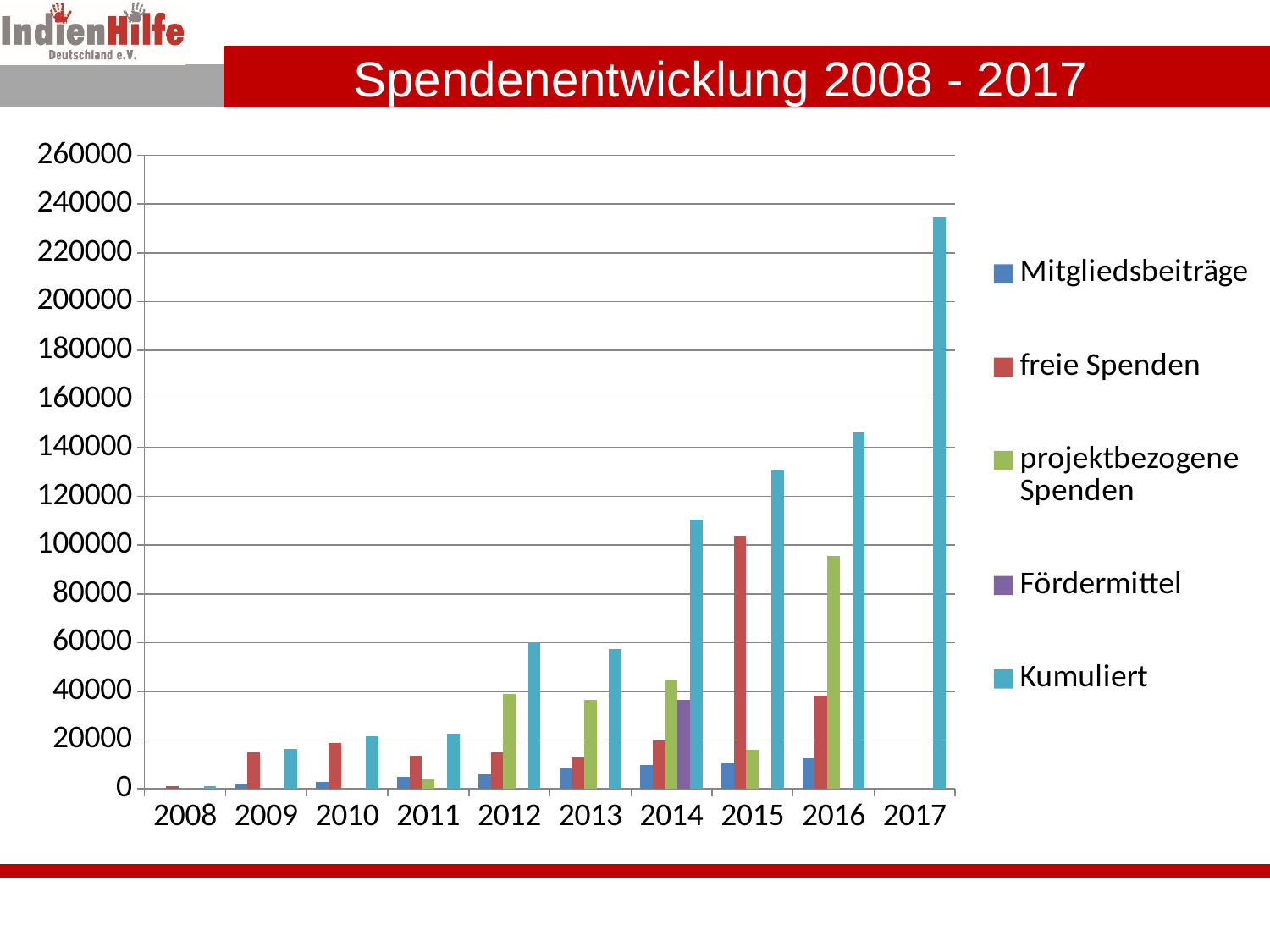
How many years are shown on the x axis? 10 Is the projektbezogene Spenden value for 2016 greater or less than 100000? less What kind of chart is shown on the slide? bar chart In which year is the Kumuliert value highest? 2017 In which year is the freie Spenden value highest? 2015 Which is larger, the Kumuliert value for 2013 or for 2014? 2014 How many series does the legend list? 5 In which year is the projektbezogene Spenden value highest? 2016 Is the Kumuliert value for 2017 greater or less than 220000? greater What is the title of the chart? Spendenentwicklung 2008 - 2017 Is the freie Spenden value for 2015 greater or less than 80000? greater Which is larger in 2016, freie Spenden or projektbezogene Spenden? projektbezogene Spenden